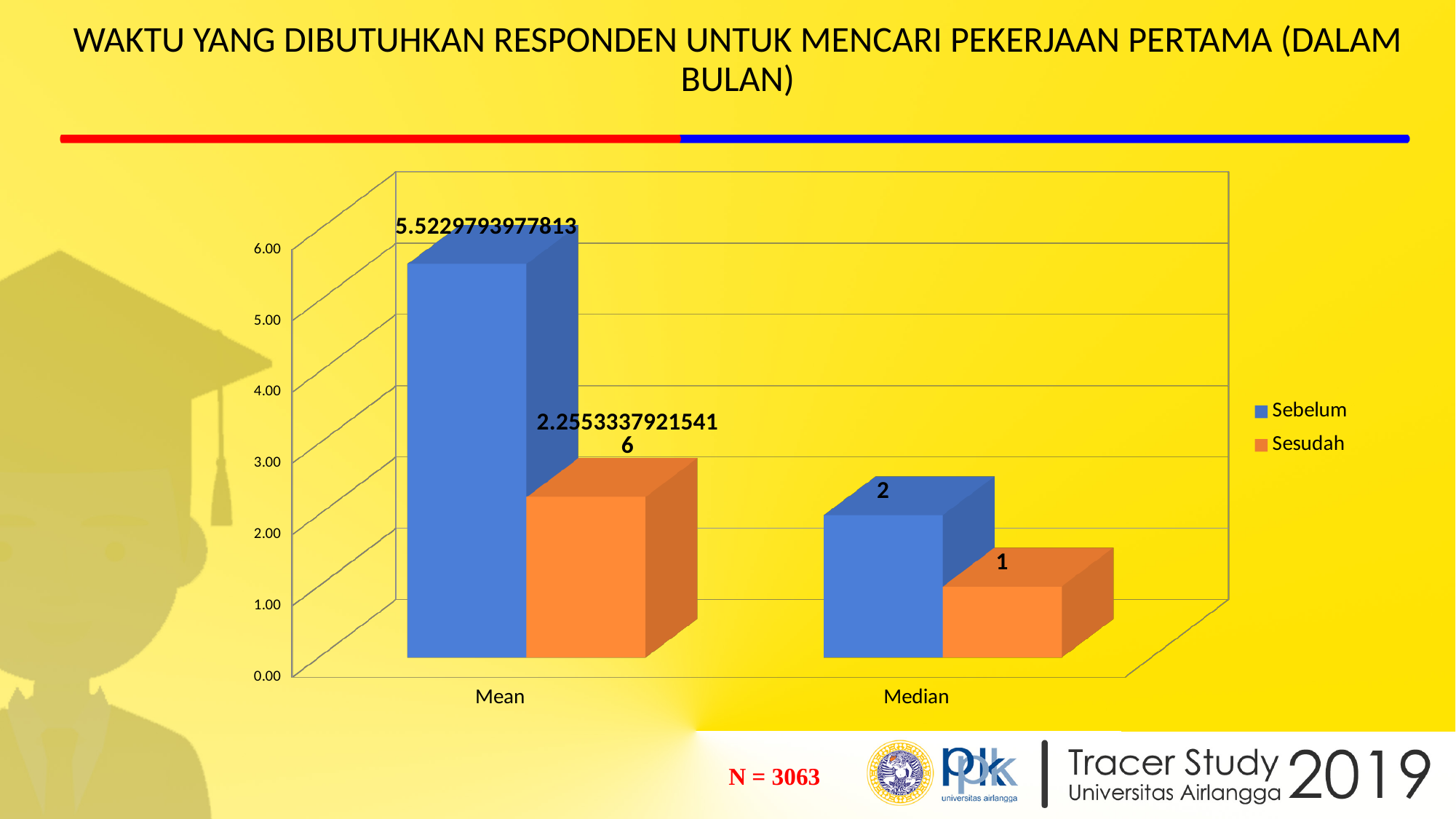
What is the Sebelum value for Mean? 5.5229793977813 What is the Sesudah value for Median? 1 How many series does the legend list? 2 Is the Sesudah value for Mean greater or less than 3.00? less What is the difference between the Sebelum and Sesudah values for Median? 1 What is the Sesudah value for Mean? 2.25533379215416 What kind of chart is shown on the slide? Bar chart How many categories are shown on the x axis? 2 Is the Sebelum value for Mean greater or less than 5.00? greater What is the Sebelum value for Median? 2 Which series has the higher value for Mean, Sebelum or Sesudah? Sebelum Which series has the lower value for Median, Sebelum or Sesudah? Sesudah